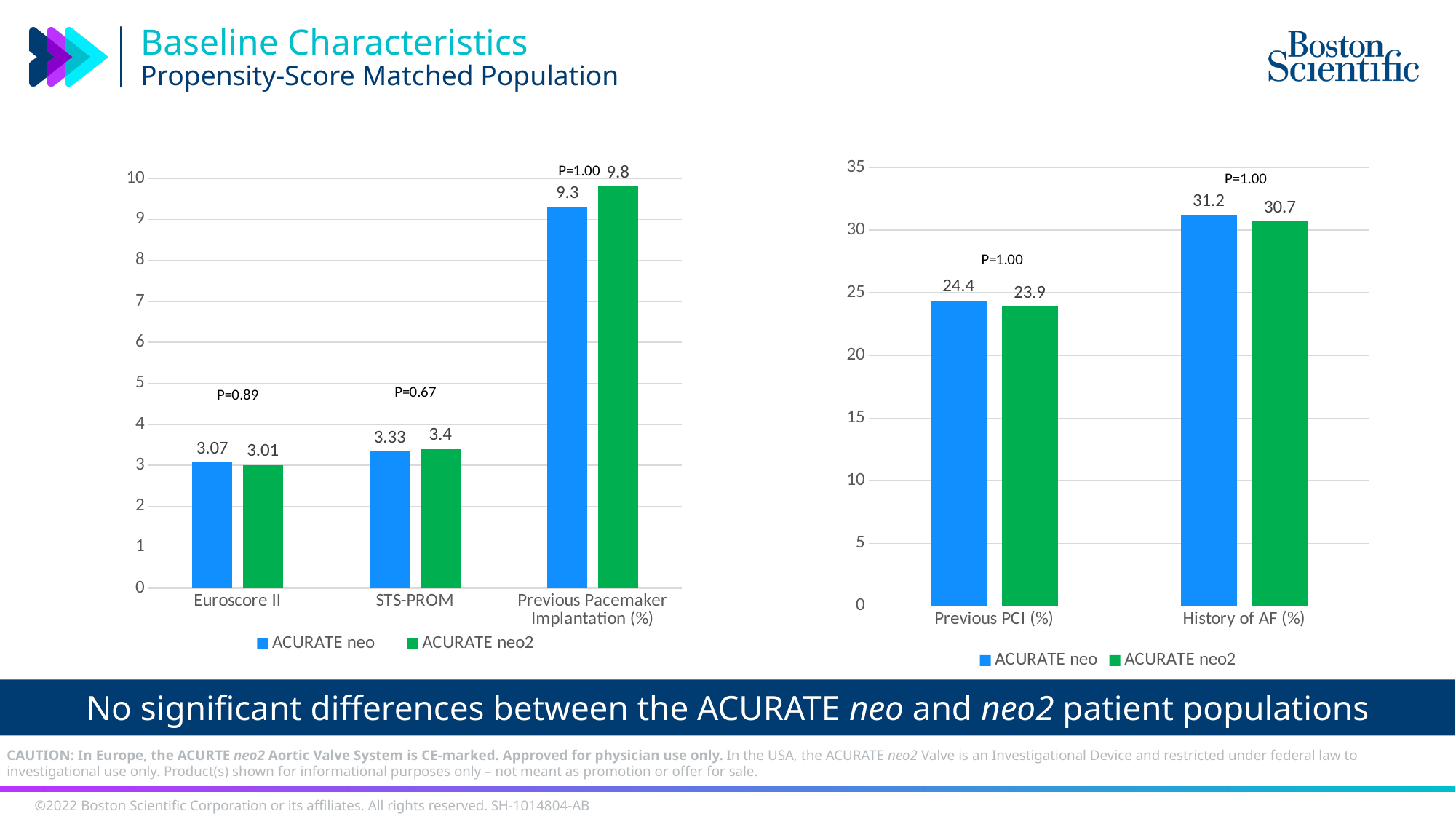
In the right chart, which category has the lowest value for ACURATE neo2? Previous PCI (%) In the right chart, what is the value for ACURATE neo2 in the History of AF (%) category? 30.7 In the right chart, what is the difference between the ACURATE neo and ACURATE neo2 values for History of AF (%)? 0.5 In the left chart, how many categories are shown on the x axis? 3 In the right chart, what is the value for ACURATE neo in the Previous PCI (%) category? 24.4 How many series does the legend of the right chart list? 2 In the left chart, what is the difference between the ACURATE neo2 and ACURATE neo values for Previous Pacemaker Implantation (%)? 0.5 In the left chart, what is the value for ACURATE neo in the Euroscore II category? 3.07 In the left chart, what P value is shown above the STS-PROM bars? P=0.67 What type of chart is the left chart? Bar chart In the left chart, what is the value for ACURATE neo2 in the Previous Pacemaker Implantation (%) category? 9.8 In the left chart, which category has the highest value for ACURATE neo? Previous Pacemaker Implantation (%)